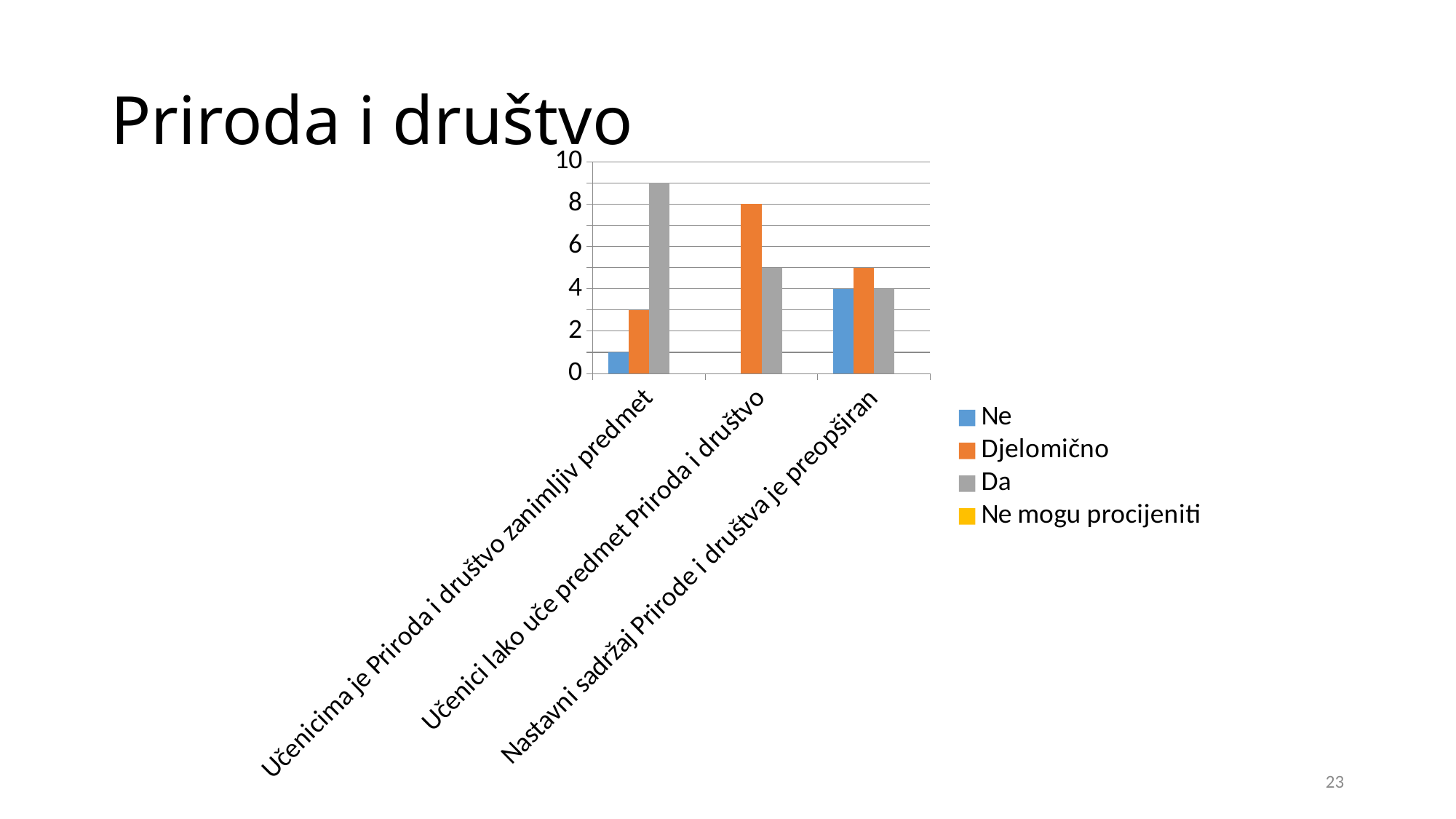
How many series does the legend list? 4 What kind of chart is shown on the slide? bar chart For 'Učenici lako uče predmet Priroda i društvo', which is larger: Djelomično or Da? Djelomično What is the title of the slide? Priroda i društvo What is the value of Da for 'Nastavni sadržaj Prirode i društva je preopširan'? 4 Which category has the highest Da value? Učenicima je Priroda i društvo zanimljiv predmet What is the value of Djelomično for 'Učenici lako uče predmet Priroda i društvo'? 8 Which category has the highest Djelomično value? Učenici lako uče predmet Priroda i društvo Is the value of Ne for 'Učenicima je Priroda i društvo zanimljiv predmet' greater or less than 2? less What is the value of Ne for 'Nastavni sadržaj Prirode i društva je preopširan'? 4 Is the value of Da for 'Učenicima je Priroda i društvo zanimljiv predmet' greater or less than 8? greater How many categories are shown on the x axis? 3